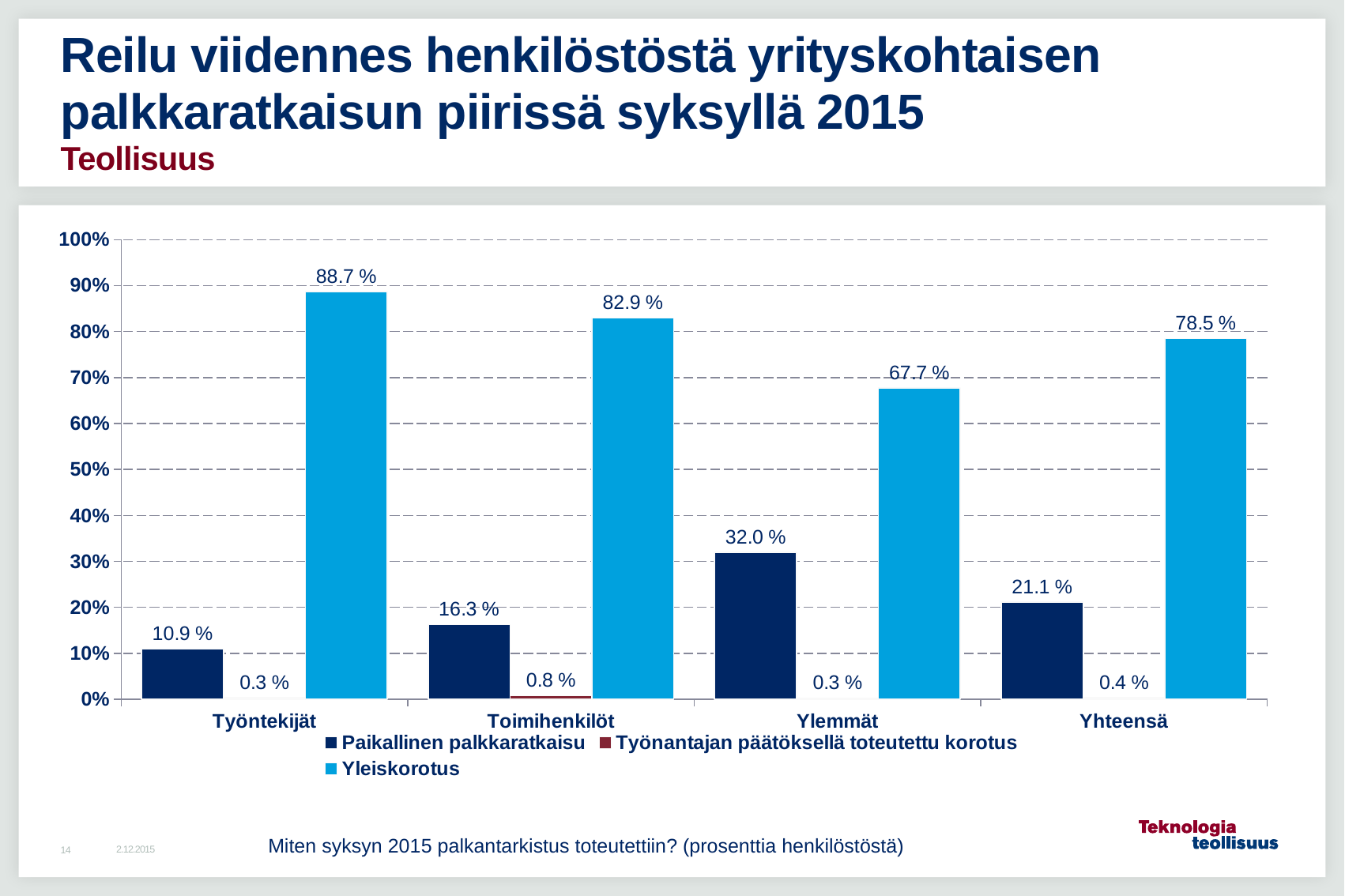
What kind of chart is shown on the slide? Bar chart What is the Paikallinen palkkaratkaisu value for Yhteensä? 21.1 % What is the Työnantajan päätöksellä toteutettu korotus value for Toimihenkilöt? 0.8 % How many categories are shown on the x axis? 4 Which category has the highest Paikallinen palkkaratkaisu value? Ylemmät How many series does the legend list? 3 What is the Paikallinen palkkaratkaisu value for Ylemmät? 32.0 % Which category has the lowest Yleiskorotus value? Ylemmät Which series is shown in light blue in the legend? Yleiskorotus Which is larger: the Paikallinen palkkaratkaisu value for Toimihenkilöt or for Yhteensä? Yhteensä What is the difference between the Yleiskorotus values for Työntekijät and Toimihenkilöt? 5.8 % What is the Yleiskorotus value for Työntekijät? 88.7 %